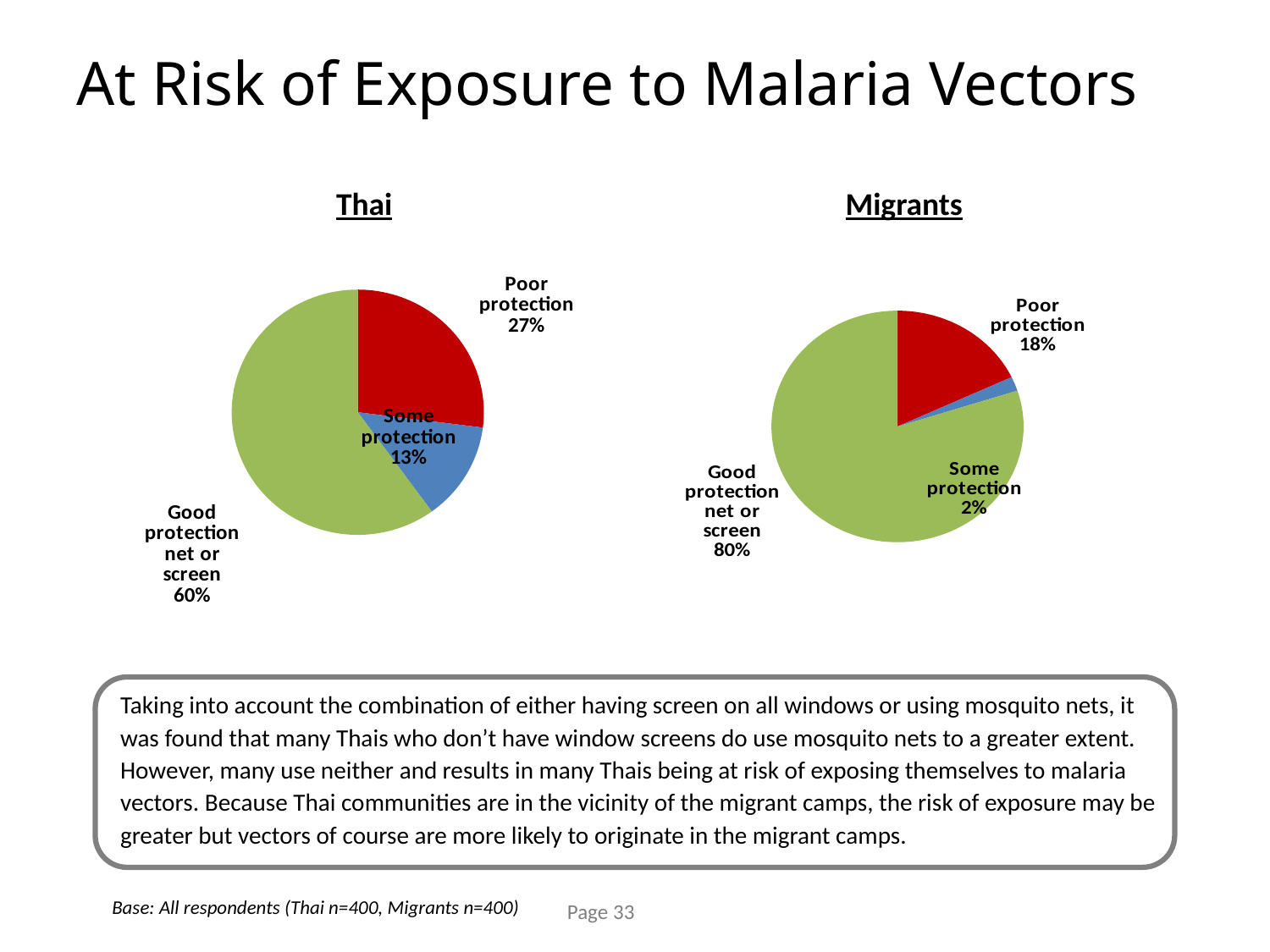
In the Migrants pie chart, which category has the smallest share? Some protection In the Thai pie chart, what percentage is labelled 'Some protection'? 13% In the Thai pie chart, what percentage is labelled 'Poor protection'? 27% What is the difference between the 'Poor protection' share in the Thai chart and the 'Poor protection' share in the Migrants chart? 9% In the Migrants pie chart, what percentage is labelled 'Good protection net or screen'? 80% In the Migrants pie chart, what share of the pie is 'Poor protection'? 18% Which is larger: 'Good protection net or screen' in the Thai chart or in the Migrants chart? Migrants In the Thai pie chart, which category has the largest share? Good protection net or screen What colour is the 'Poor protection' slice in the Thai pie chart? Red What type of chart is used for the Migrants data? Pie chart How many slices does the Thai pie chart have? 3 In the Migrants pie chart, what percentage is labelled 'Some protection'? 2%